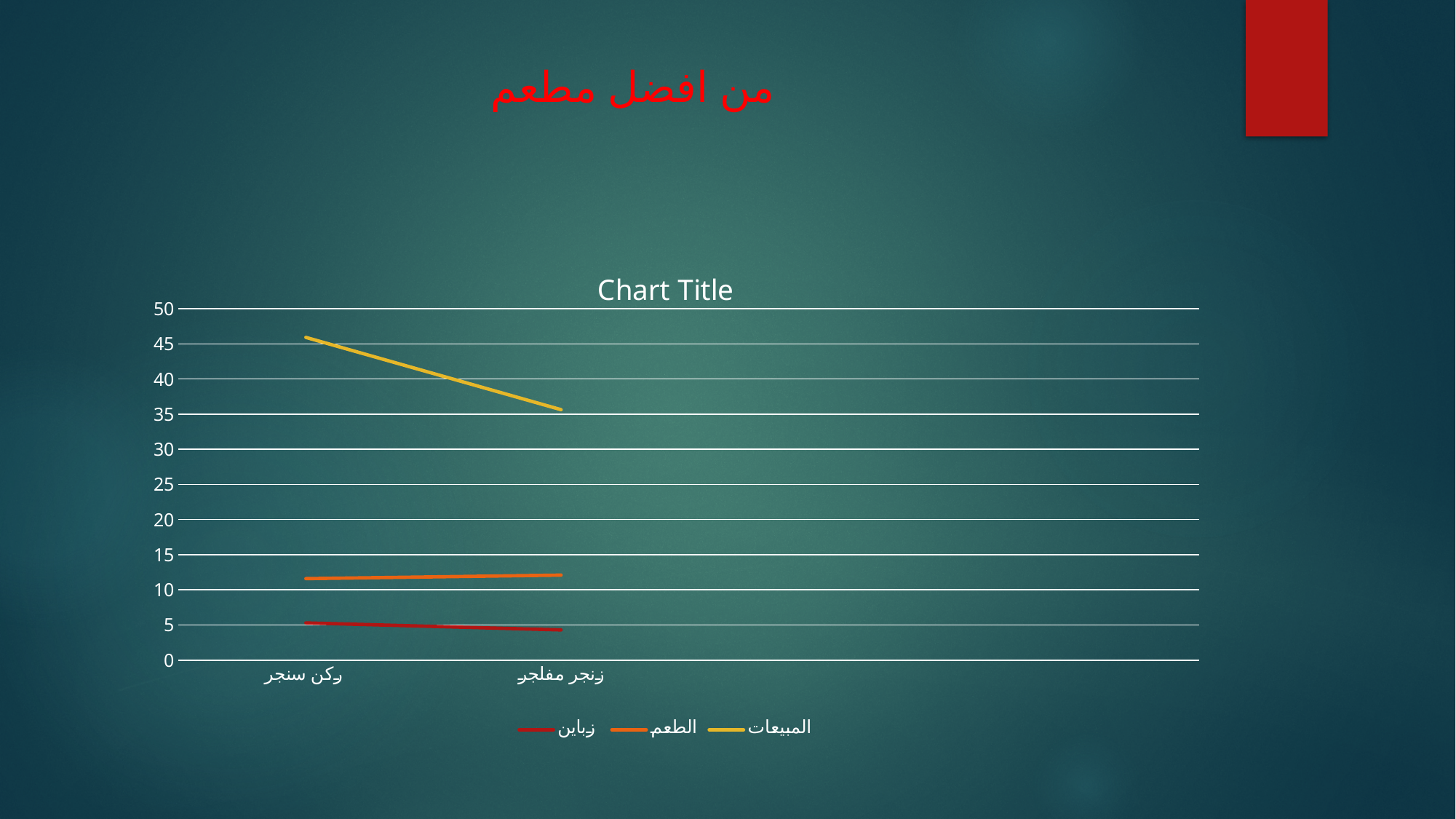
How many categories are shown on the x axis? 2 Which series has the highest values on the chart? المبيعات Does the المبيعات line rise or fall from ركن سنجر to زنجر مفلجر? falls What kind of chart is shown on the slide? line chart Which category has the larger value for المبيعات, ركن سنجر or زنجر مفلجر? ركن سنجر Is the value of المبيعات for زنجر مفلجر greater or less than 40? less Which series has the lowest values on the chart? زباين How many series does the legend list? 3 Is the value of زباين for زنجر مفلجر greater or less than 10? less What is the title shown above the chart? Chart Title